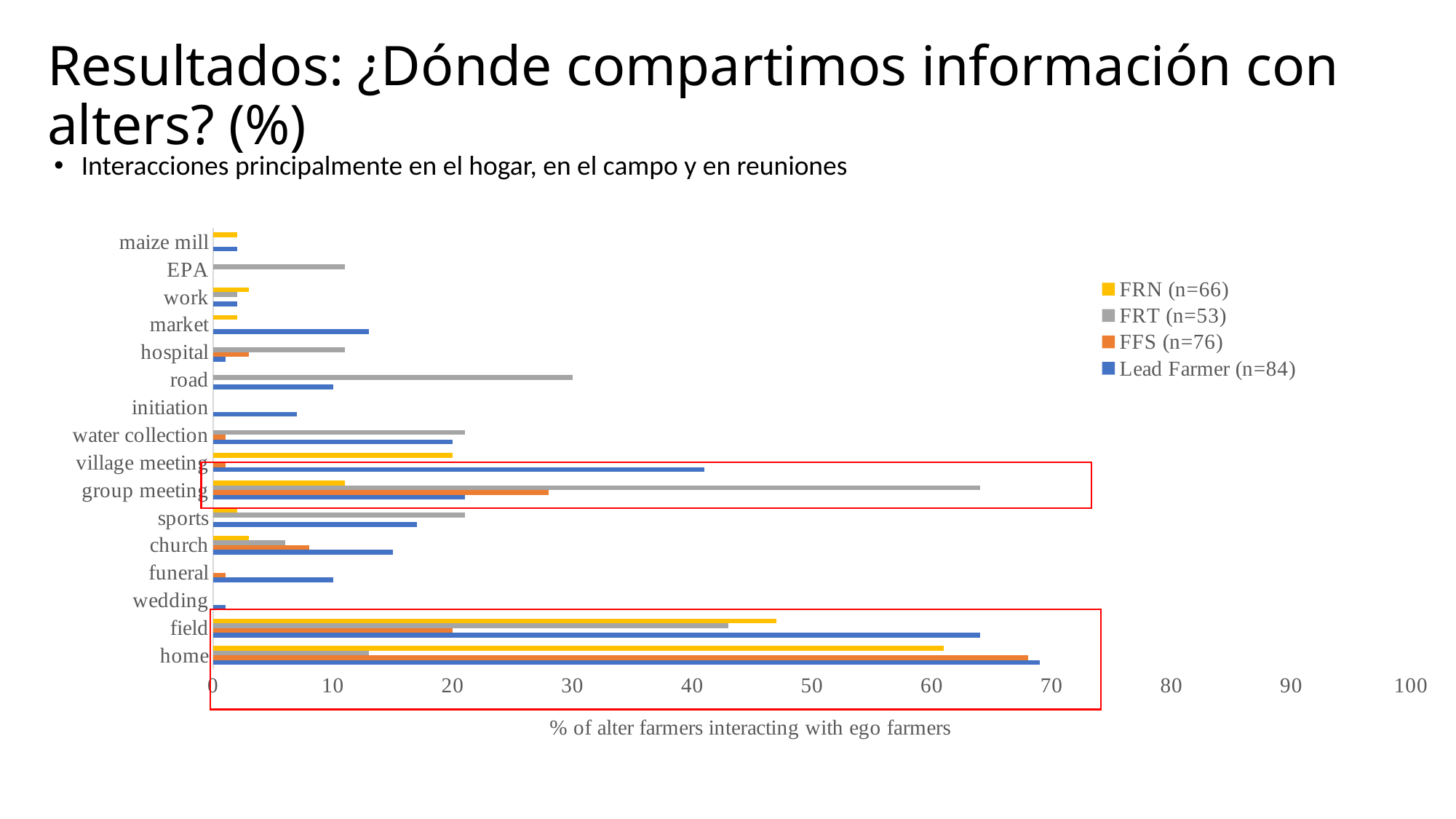
Is the value for field in the FRN (n=66) series greater or less than 40? greater What is the title of the horizontal axis of the chart? % of alter farmers interacting with ego farmers Is the value for home in the Lead Farmer (n=84) series greater or less than 60? greater For the home category, which is larger: the FFS (n=76) value or the FRT (n=53) value? FFS (n=76) For the road category, which is larger: the FRT (n=53) value or the Lead Farmer (n=84) value? FRT (n=53) Is the value for initiation in the Lead Farmer (n=84) series greater or less than 10? less What kind of chart is shown on the slide? bar chart Which category has the highest value for the FRN (n=66) series? home Which category has the highest value for the Lead Farmer (n=84) series? home How many series does the legend list? 4 How many categories are shown on the vertical axis of the chart? 16 Which category has the highest value for the FRT (n=53) series? group meeting